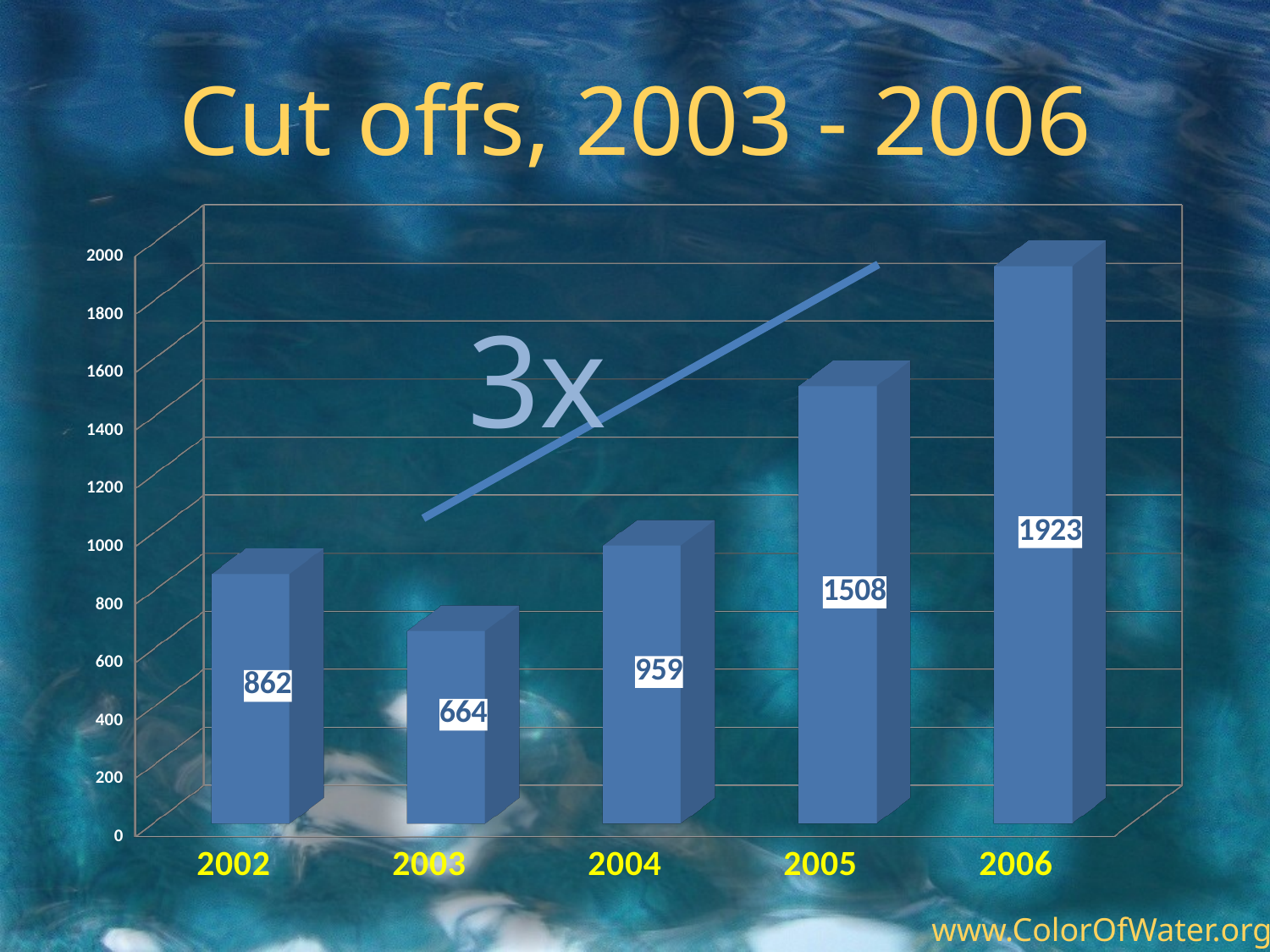
Which is larger, the value for 2002 or the value for 2004? 2004 Is the value for 2005 greater or less than 1400? greater Which year has the highest value? 2006 How many years are shown on the x axis? 5 What is the value for 2002? 862 What is the value for 2003? 664 What kind of chart is shown on the slide? bar chart Which year has the lowest value? 2003 What is the value for 2005? 1508 What is the difference between the values for 2006 and 2003? 1259 What is the title of the slide? Cut offs, 2003 - 2006 Do the values rise or fall from 2003 to 2006? rise